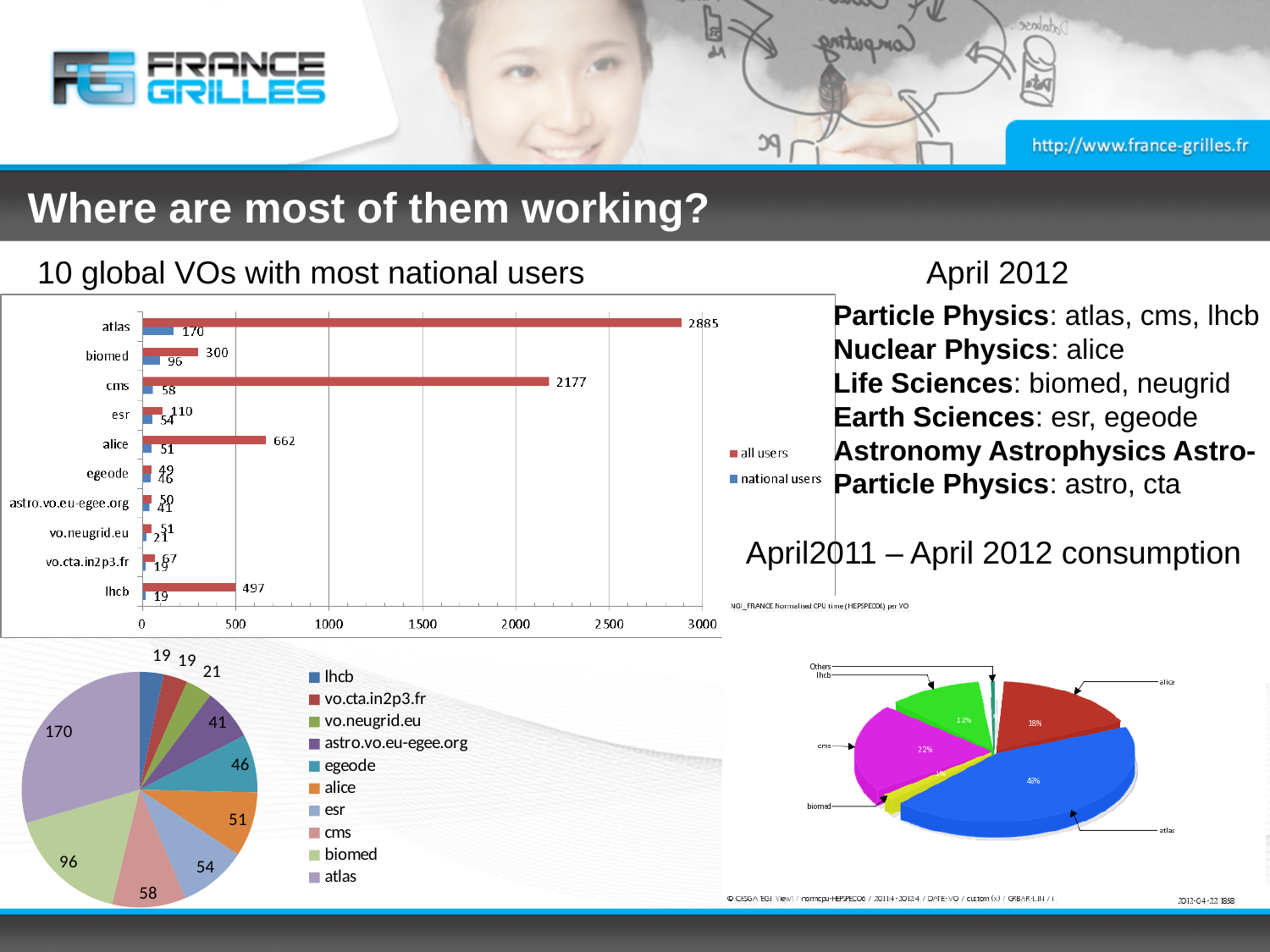
In the pie chart at the bottom left, what is the value for the esr slice? 54 In the bar chart '10 global VOs with most national users', how many series does the legend list? 2 In the bar chart '10 global VOs with most national users', which has more all users, alice or lhcb? alice In the bar chart '10 global VOs with most national users', how many VOs are shown on the vertical axis? 10 In the pie chart at the bottom left, what is the value for the atlas slice? 170 In the pie chart at the bottom left, which VO has the largest slice? atlas In the bar chart '10 global VOs with most national users', how many 'all users' does atlas have? 2885 In the bar chart '10 global VOs with most national users', how many national users does biomed have? 96 In the 3D pie chart at the bottom right (April 2011 – April 2012 consumption), what percentage is shown for the atlas slice? 46% In the bar chart '10 global VOs with most national users', what is the difference between all users and national users for cms? 2119 What type of chart is the top-left chart '10 global VOs with most national users'? bar chart In the bar chart '10 global VOs with most national users', which VO has the highest number of all users? atlas